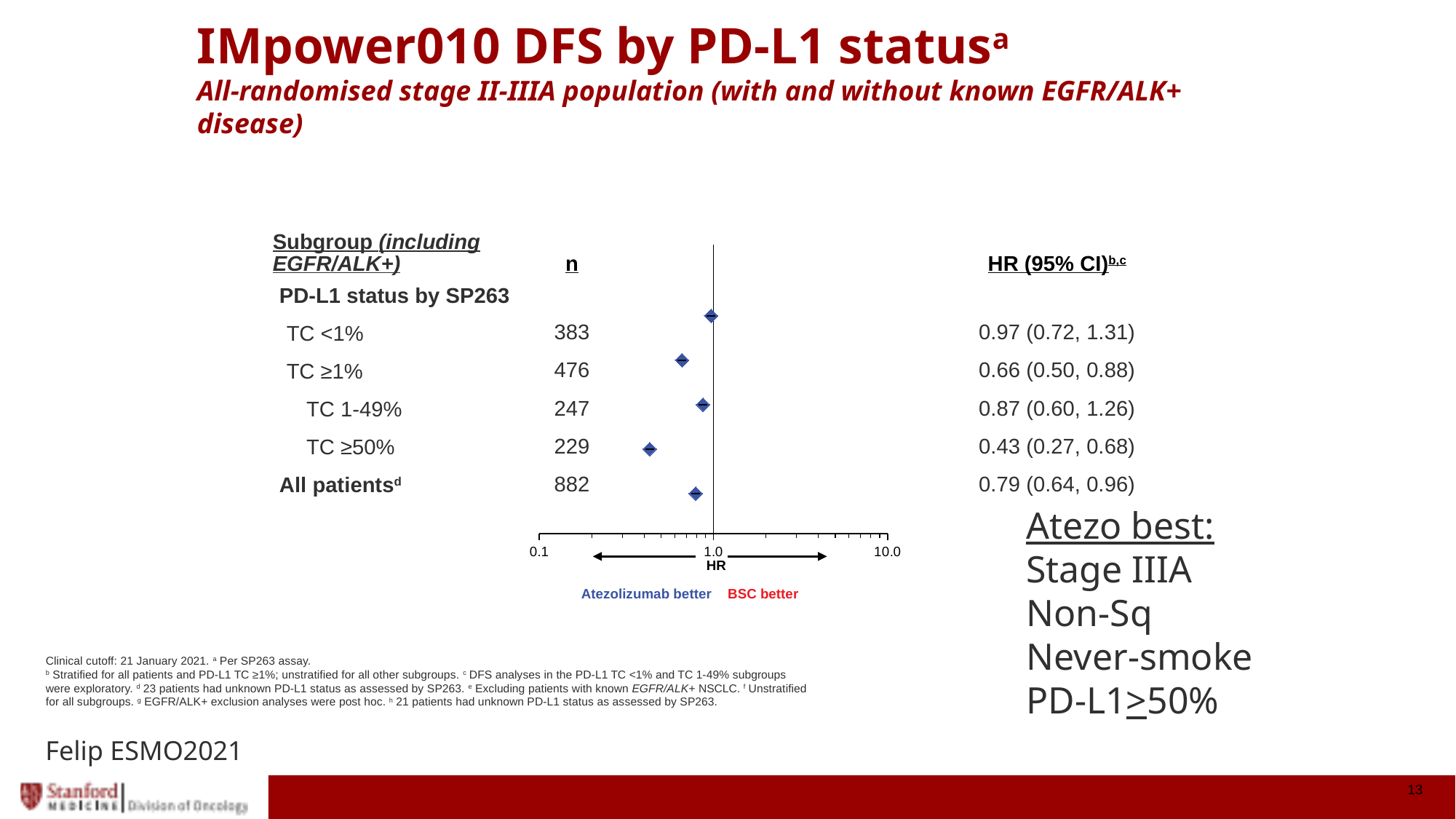
What is the HR for all patients? 0.79 What is the difference in HR between the TC <1% and TC ≥50% subgroups? 0.54 Which subgroup has the highest hazard ratio? TC <1% Is the HR for the TC ≥50% subgroup greater or less than 1.0? less What does the left side of the HR axis indicate, according to the label below the plot? Atezolizumab better What is the hazard ratio (HR) for the TC ≥50% subgroup? 0.43 Which subgroup has the lowest hazard ratio? TC ≥50% What kind of chart is shown on the slide? Forest plot How many subgroup rows are plotted in the forest plot? 5 What is the HR with 95% CI for the TC <1% subgroup? 0.97 (0.72, 1.31) Which has a larger HR, TC 1-49% or TC ≥1%? TC 1-49% How many patients (n) are in the TC ≥1% subgroup? 476